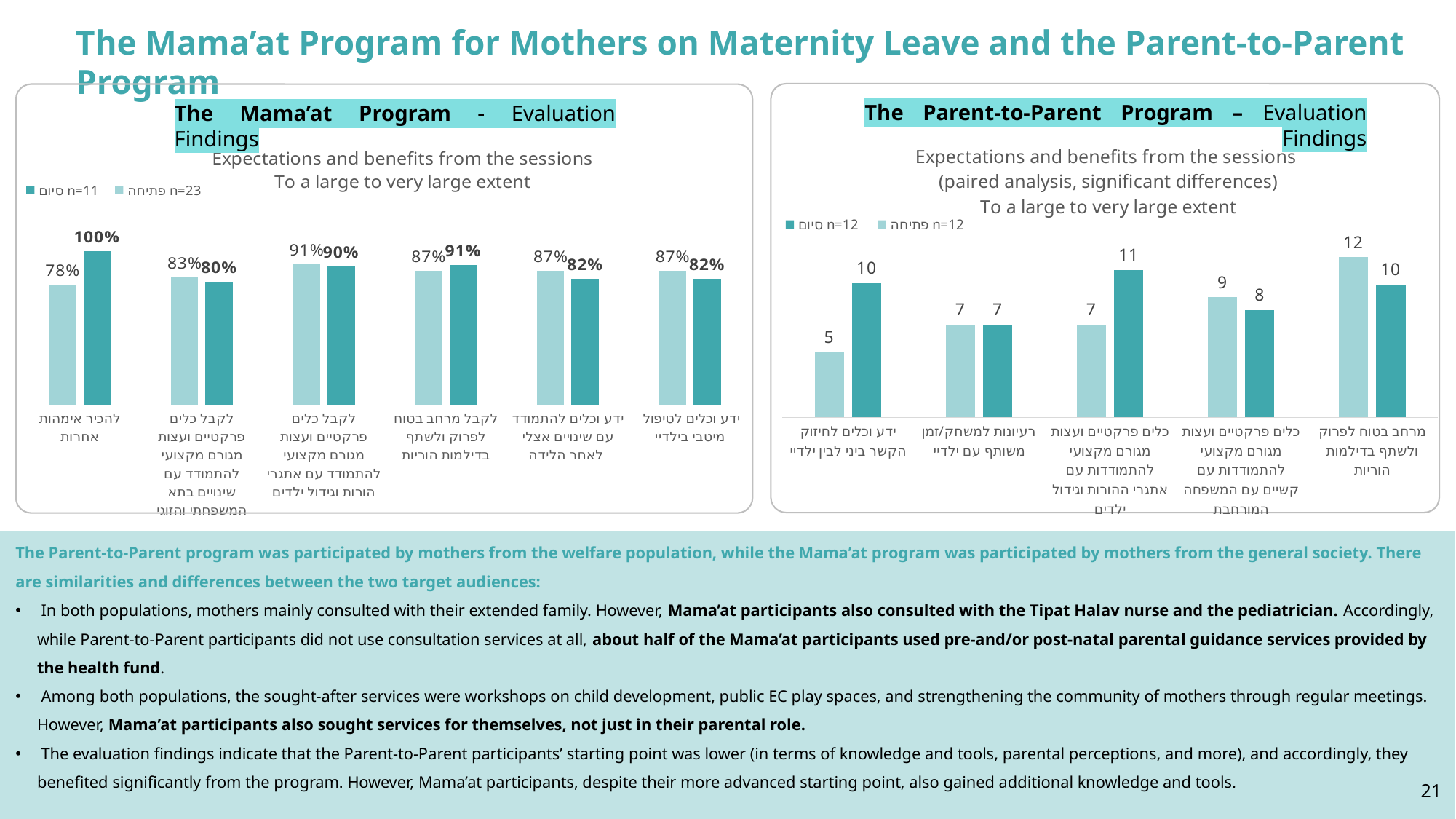
In the Parent-to-Parent Program chart on the right, is the סיום value for 'כלים פרקטיים ועצות מגורם מקצועי להתמודדות עם אתגרי ההורות וגידול ילדים' larger or smaller than its פתיחה value? larger In the Parent-to-Parent Program chart on the right, which category has the highest פתיחה (light bar) value? מרחב בטוח לפרוק ולשתף בדילמות הוריות In the Mama'at Program chart on the left, how many categories are shown on the x axis? 6 In the Parent-to-Parent Program chart on the right, what is the value of the light (פתיחה) bar for 'ידע וכלים לחיזוק הקשר ביני לבין ילדיי'? 5 In the Mama'at Program chart on the left, what is the difference between the סיום and פתיחה values for 'להכיר אימהות אחרות'? 22 percentage points In the Parent-to-Parent Program chart on the right, which category has the lowest פתיחה (light bar) value? ידע וכלים לחיזוק הקשר ביני לבין ילדיי In the Mama'at Program chart on the left, what is the value of the dark (סיום) bar for the category 'להכיר אימהות אחרות'? 100% In the Mama'at Program chart on the left, what sample size does the legend give for פתיחה? n=23 What type of chart is the Parent-to-Parent Program chart on the right? Bar chart In the Parent-to-Parent Program chart on the right, what is the value of the dark (סיום) bar for 'ידע וכלים לחיזוק הקשר ביני לבין ילדיי'? 10 In the Mama'at Program chart on the left, what is the value of the light (פתיחה) bar for the category 'להכיר אימהות אחרות'? 78% In the Parent-to-Parent Program chart on the right, how many series does the legend list? 2